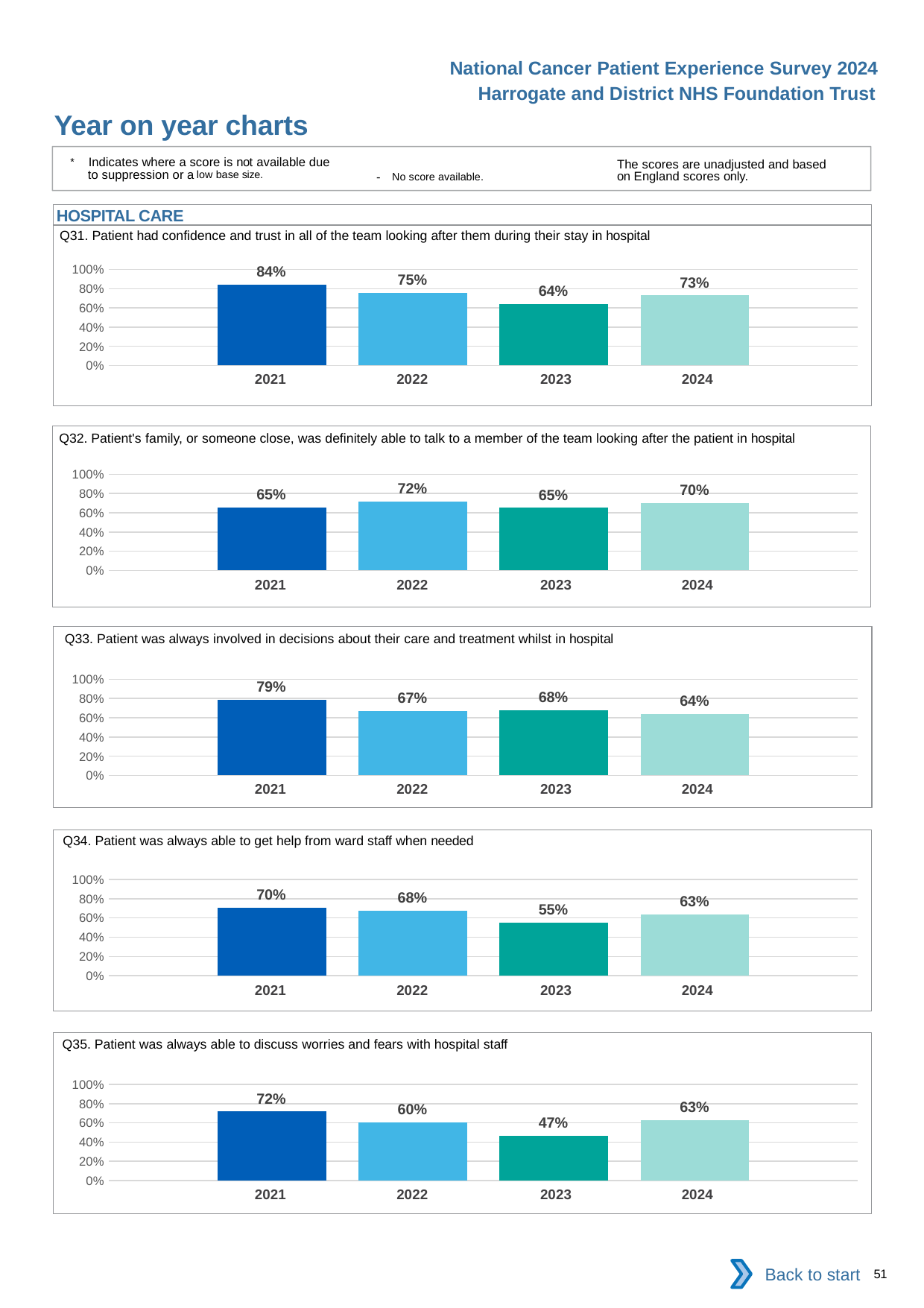
In the Q33 chart (patient was always involved in decisions about their care), what is the value for 2022? 67% In the Q34 chart (patient was always able to get help from ward staff), is the value for 2021 greater or less than 60%? greater In the Q32 chart (patient's family was definitely able to talk to a member of the team), which year has the highest value? 2022 In the Q34 chart (patient was always able to get help from ward staff), which year has the lowest value? 2023 In the Q35 chart (patient was always able to discuss worries and fears), which is larger, the value for 2022 or the value for 2024? 2024 In the Q31 chart (patient had confidence and trust in all of the team), which year has the lowest value? 2023 In the Q33 chart (patient was always involved in decisions about their care), what is the difference between the 2021 and 2024 values? 15 percentage points How many years are shown on the x axis of the Q31 chart? 4 In the Q31 chart (patient had confidence and trust in all of the team), what is the value for 2021? 84% In the Q32 chart (patient's family was definitely able to talk to a member of the team), what is the value for 2024? 70% What kind of chart is used for Q35 (patient was always able to discuss worries and fears)? Bar chart In the Q35 chart (patient was always able to discuss worries and fears), what is the value for 2023? 47%